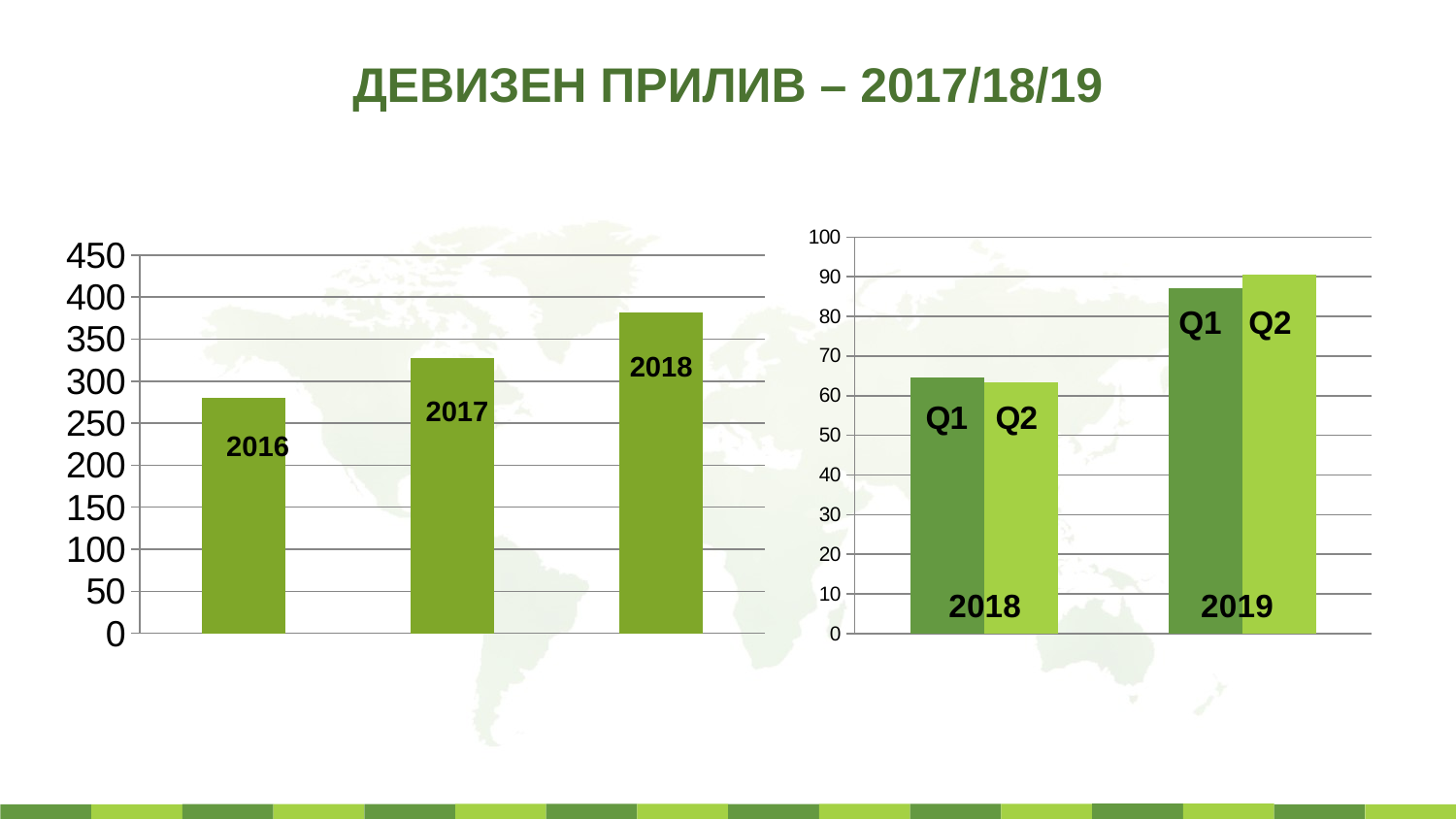
In the chart on the left, is the value for 2018 greater or less than 350? greater In the chart on the left, do the values rise or fall from 2016 to 2018? rise What kind of chart is the chart on the left side of the slide? bar chart In the chart on the left, which year has the lowest bar? 2016 What is the title of the slide? ДЕВИЗЕН ПРИЛИВ – 2017/18/19 How many bars are shown in the chart on the left? 3 In the chart on the right, is the Q2 value for 2019 greater or less than 80? greater In the chart on the left, is the value for 2017 greater or less than 350? less In the chart on the right, which is larger: Q1 for 2018 or Q1 for 2019? Q1 for 2019 In the chart on the left, which year has the highest bar? 2018